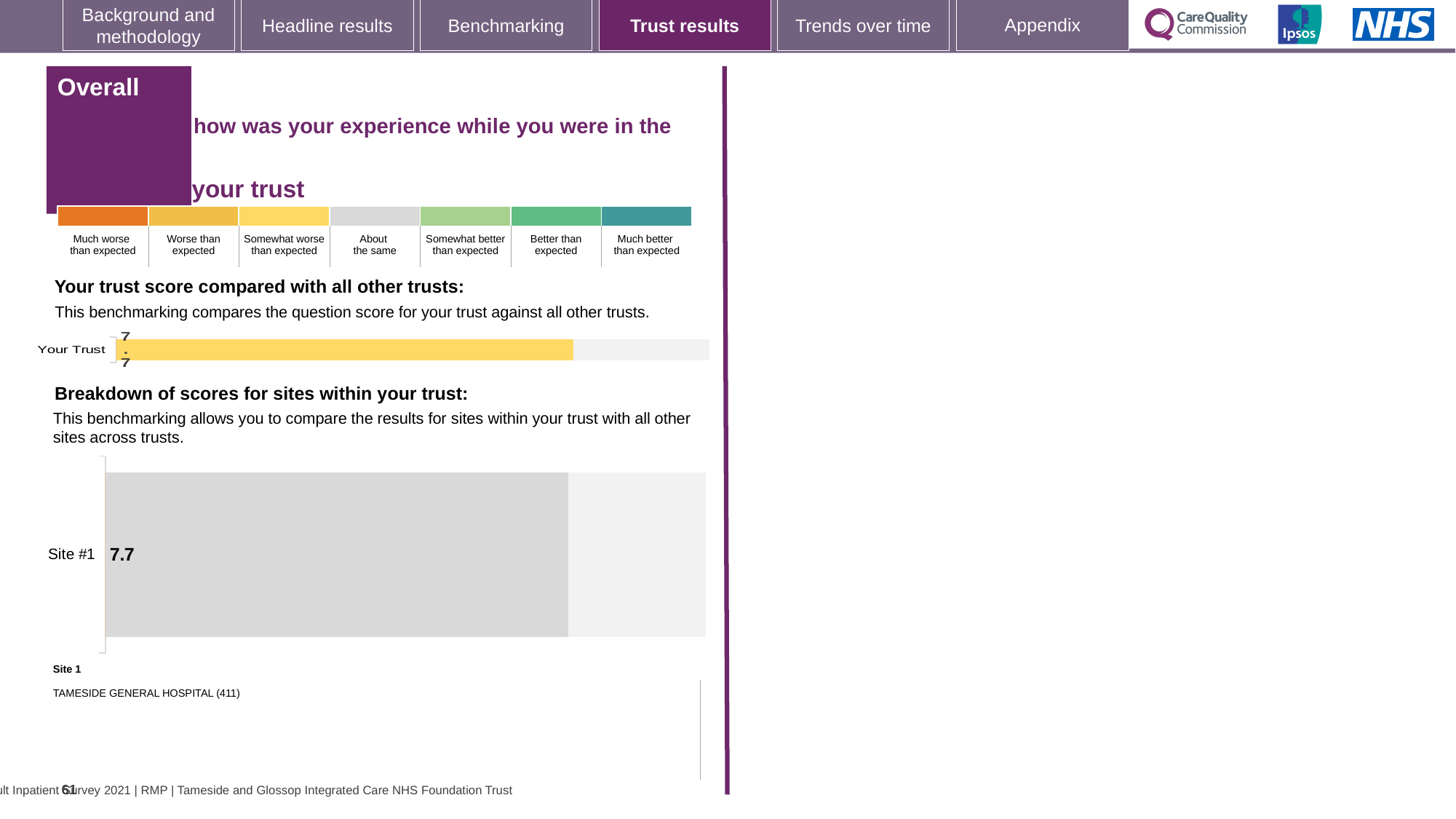
What kind of chart is the 'Breakdown of scores for sites within your trust' chart? bar chart In the 'Your trust score compared with all other trusts' chart, what colour is the bar for Your Trust? yellow What kind of chart is the 'Your trust score compared with all other trusts' chart? bar chart In the 'Breakdown of scores for sites within your trust' chart, what is the score for Site #1? 7.7 In the 'Breakdown of scores for sites within your trust' chart, what is the label of the only bar? Site #1 How many bars are plotted in the 'Your trust score compared with all other trusts' chart? 1 In the 'Your trust score compared with all other trusts' chart, what is the score for Your Trust? 7.7 Is the score for Site #1 in the 'Breakdown of scores for sites within your trust' chart the same as the score for Your Trust in the chart above it? Yes How many sites are plotted in the 'Breakdown of scores for sites within your trust' chart? 1 Which hospital is listed as Site 1 below the 'Breakdown of scores for sites within your trust' chart? TAMESIDE GENERAL HOSPITAL (411)